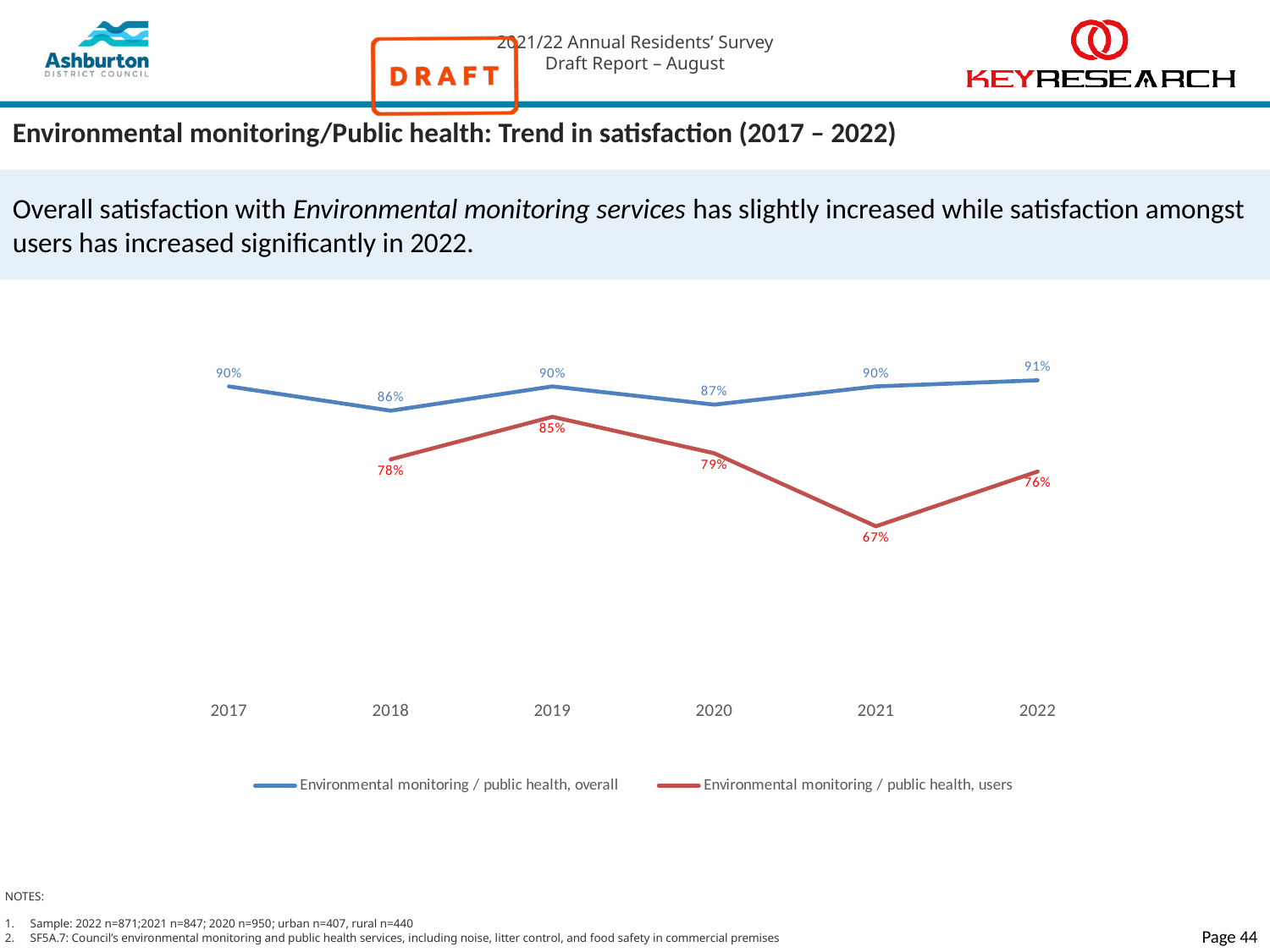
In which year is the value for Environmental monitoring / public health, users the lowest? 2021 What is the value for Environmental monitoring / public health, overall in 2022? 91% What type of chart is shown on the slide? Line chart What is the difference between the users values in 2022 and 2021? 9% How many series does the legend list? 2 What is the value for Environmental monitoring / public health, users in 2018? 78% How many years are shown on the x axis? 6 In which year is the value for Environmental monitoring / public health, users the highest? 2019 What is the difference between the overall and users values in 2021? 23% What is the value for Environmental monitoring / public health, users in 2021? 67% In which year is the value for Environmental monitoring / public health, overall the highest? 2022 Which is larger in 2019: the overall value or the users value? Overall